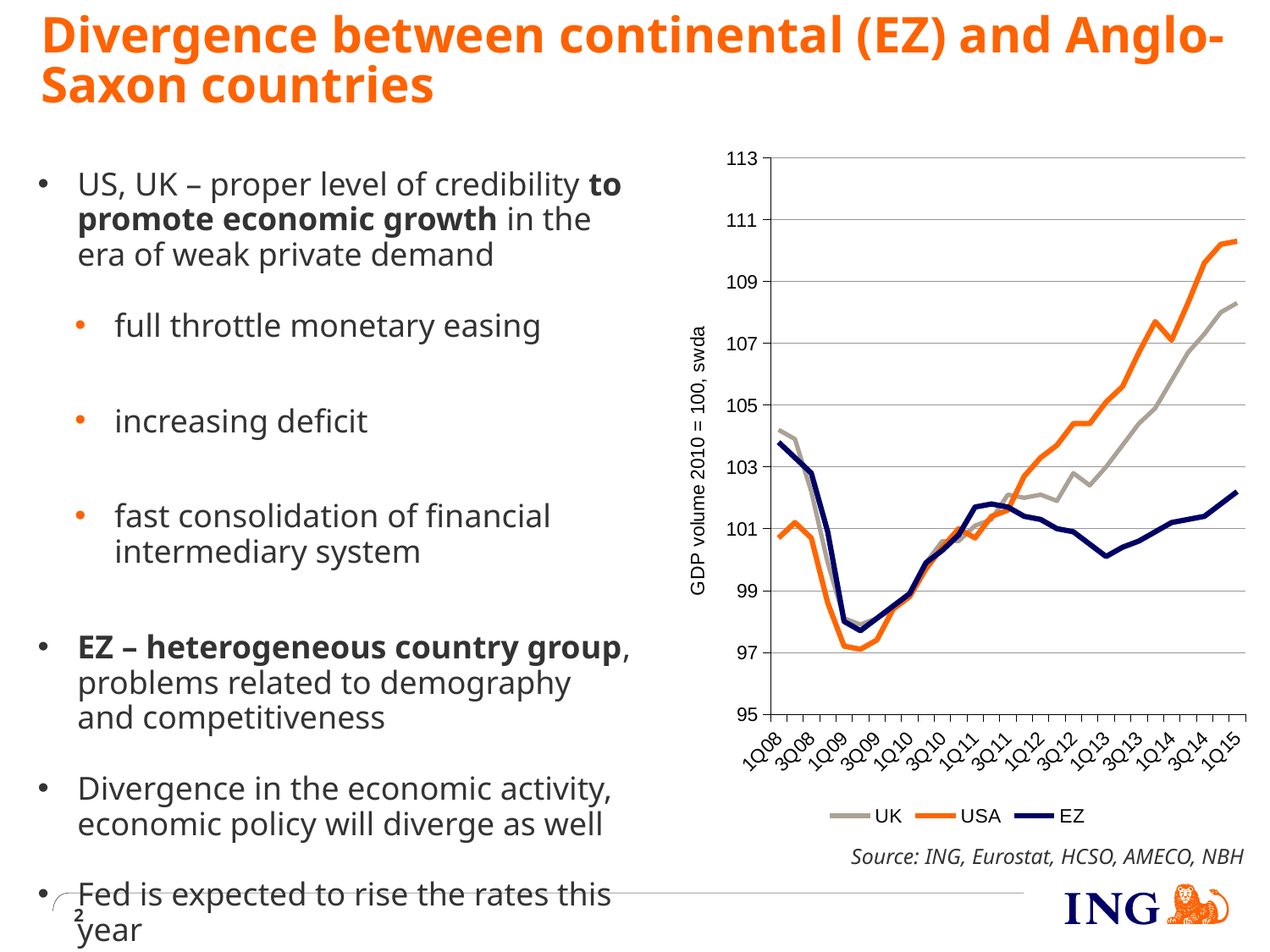
Which series has the highest value at 1Q15? USA At 1Q15, which is larger, the value for UK or the value for EZ? UK Does the USA series rise or fall between 1Q09 and 1Q15? rise Is the value for USA at 1Q15 greater or less than 109? greater Which series has the lowest value at 1Q08? USA What are the three series named in the chart's legend? UK, USA, EZ Is the value for USA at 1Q09 greater or less than 99? less Is the value for EZ at 1Q15 greater or less than 103? less Which series has the lowest value at 1Q15? EZ What is the label on the chart's vertical axis? GDP volume 2010 = 100, swda How many series does the chart's legend list? 3 What kind of chart is shown on the slide? line chart